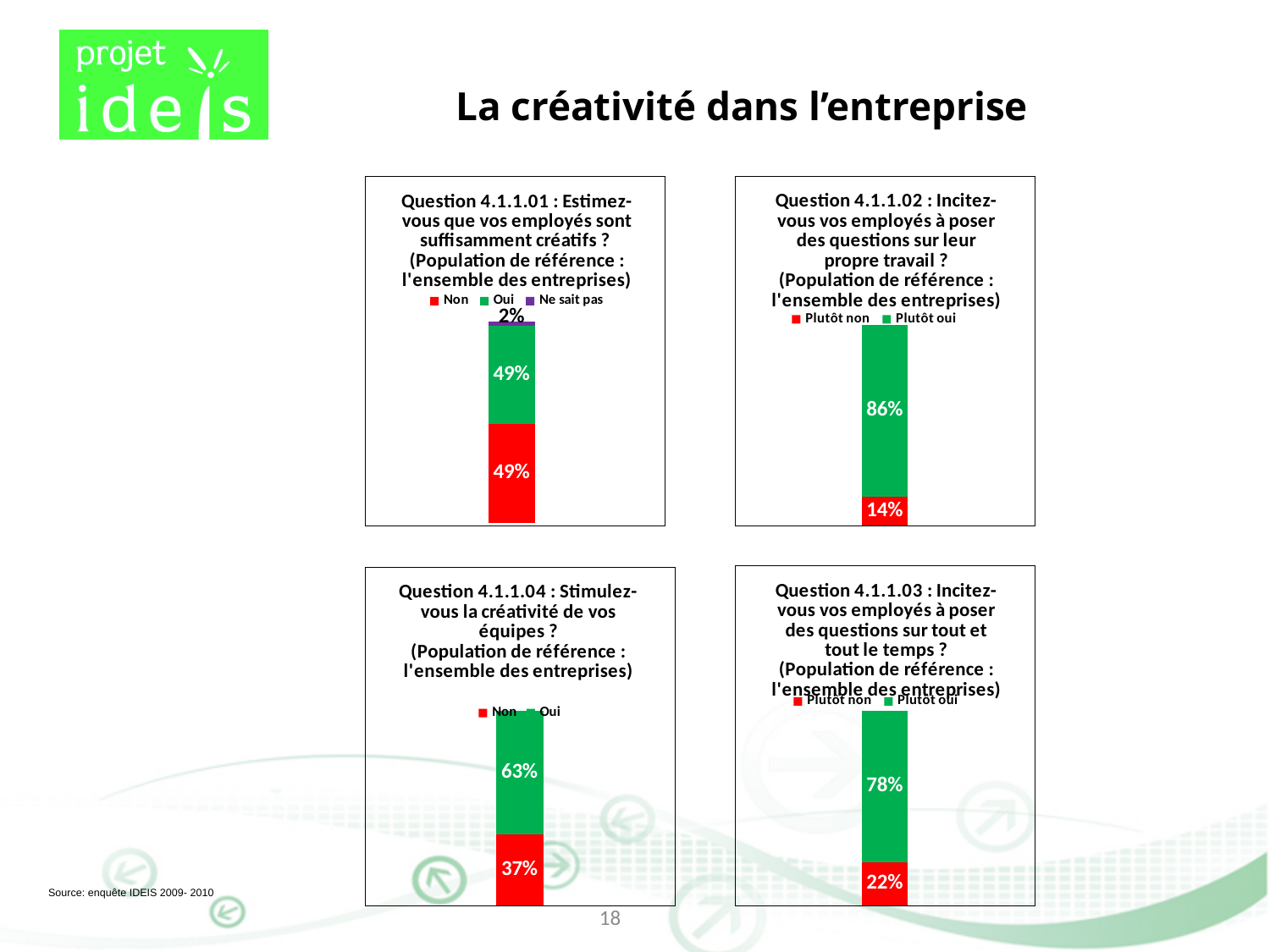
How many series does the legend list in the chart for Question 4.1.1.01 (top left)? 3 In the chart for Question 4.1.1.01 (top left), what is the value for "Ne sait pas"? 2% In the chart for Question 4.1.1.04 (bottom left), what is the value for "Non"? 37% In the chart for Question 4.1.1.04 (bottom left), which response has the highest value? Oui In the chart for Question 4.1.1.02 (top right), what is the difference between "Plutôt oui" and "Plutôt non"? 72% In the chart for Question 4.1.1.03 (bottom right), what is the value for "Plutôt oui"? 78% What kind of chart is used for Question 4.1.1.02 (top right)? Stacked bar chart In the chart for Question 4.1.1.03 (bottom right), which is larger, "Plutôt oui" or "Plutôt non"? Plutôt oui In the chart for Question 4.1.1.03 (bottom right), which response has the lowest value? Plutôt non In the chart for Question 4.1.1.04 (bottom left), what is the difference between "Oui" and "Non"? 26% In the chart for Question 4.1.1.02 (top right), what is the value for "Plutôt oui"? 86% In the chart for Question 4.1.1.02 (top right), what is the value for "Plutôt non"? 14%